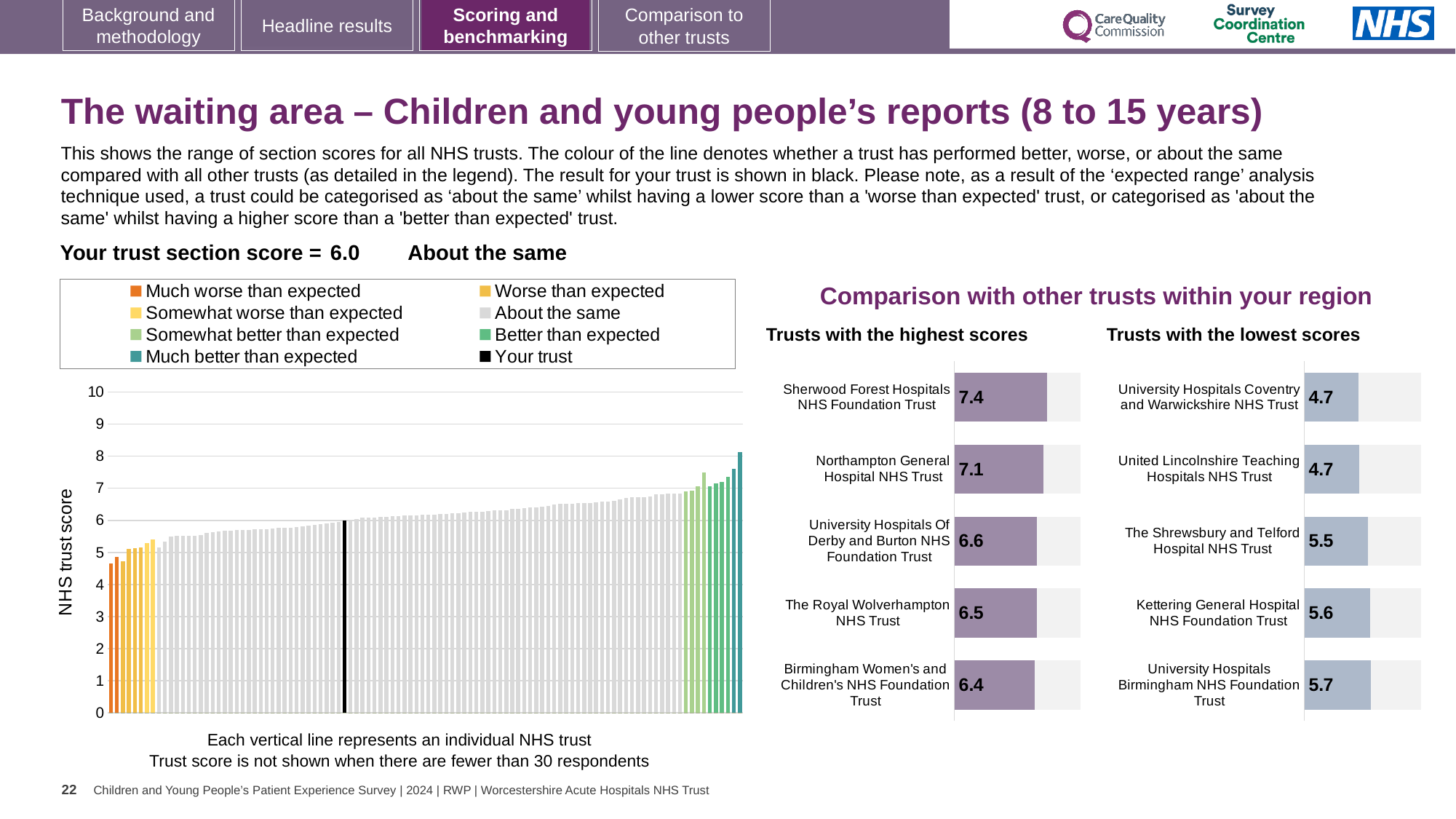
How many trusts are shown in the 'Trusts with the lowest scores' chart? 5 How many entries does the legend of the large 'NHS trust score' chart on the left list? 8 In the 'Trusts with the lowest scores' chart, which trust has the highest score? University Hospitals Birmingham NHS Foundation Trust In the 'Trusts with the lowest scores' chart, which has the larger score: Kettering General Hospital NHS Foundation Trust or The Shrewsbury and Telford Hospital NHS Trust? Kettering General Hospital NHS Foundation Trust What kind of chart is the large 'NHS trust score' chart on the left of the slide? Bar chart In the 'Trusts with the highest scores' chart, what is the score for Sherwood Forest Hospitals NHS Foundation Trust? 7.4 In the large 'NHS trust score' chart on the left, do the bar heights rise or fall from left to right? Rise In the large 'NHS trust score' chart on the left, is the value of the leftmost bar greater or less than 6? less In the 'Trusts with the highest scores' chart, what is the score for The Royal Wolverhampton NHS Trust? 6.5 In the 'Trusts with the lowest scores' chart, what is the score for The Shrewsbury and Telford Hospital NHS Trust? 5.5 In the 'Trusts with the highest scores' chart, which trust has the lowest score? Birmingham Women's and Children's NHS Foundation Trust In the 'Trusts with the highest scores' chart, what is the difference between the scores of Sherwood Forest Hospitals NHS Foundation Trust and Northampton General Hospital NHS Trust? 0.3